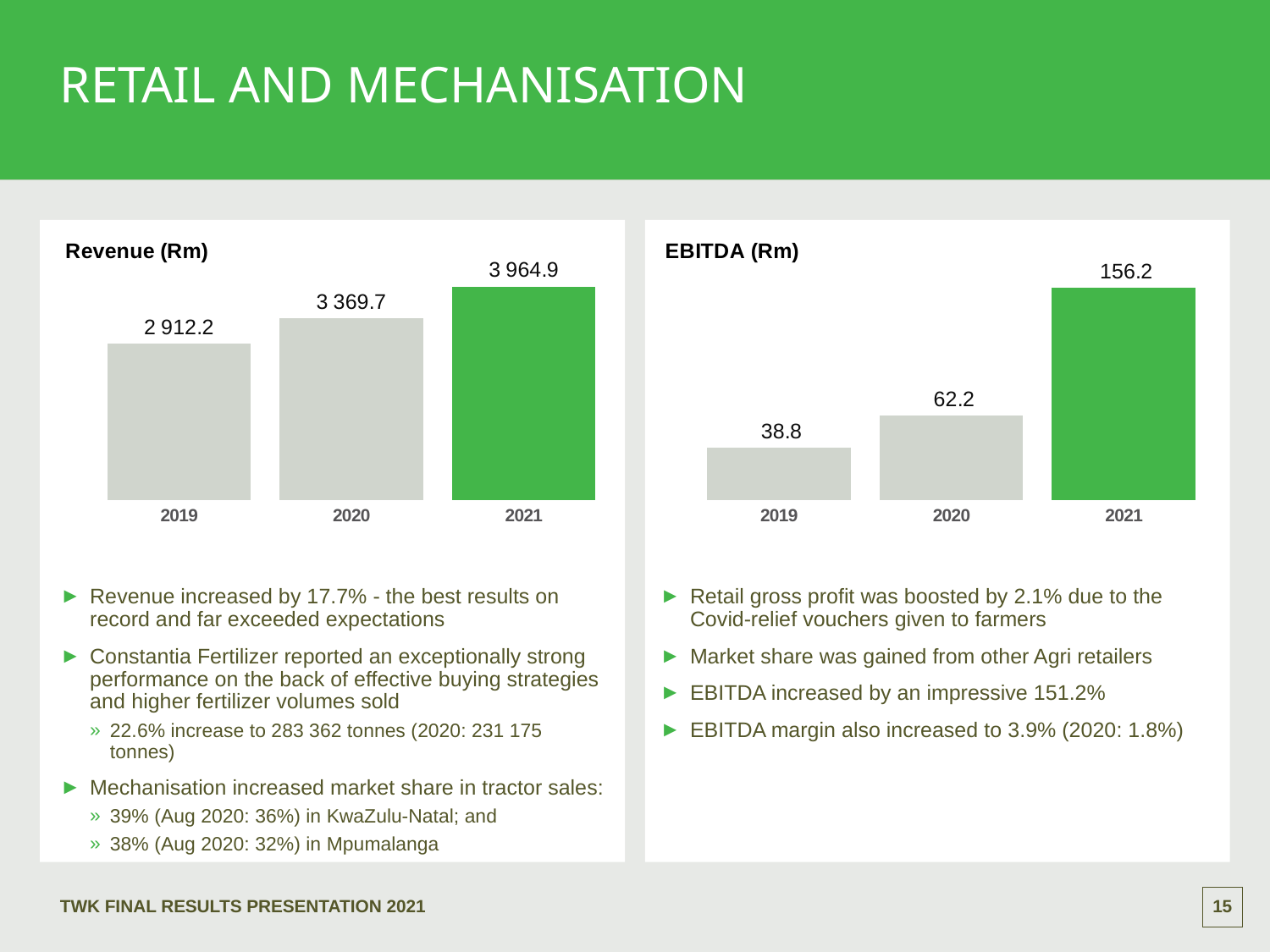
In the Revenue (Rm) chart, what is the difference between the 2021 and 2020 values? 595.2 How many years are shown in the Revenue (Rm) chart? 3 In the EBITDA (Rm) chart, what is the value for 2020? 62.2 What kind of chart is the EBITDA (Rm) chart? Bar chart In the Revenue (Rm) chart, what is the value for 2021? 3 964.9 In the Revenue (Rm) chart, what is the value for 2019? 2 912.2 In the EBITDA (Rm) chart, what is the value for 2019? 38.8 In the EBITDA (Rm) chart, which year has the highest value? 2021 In the EBITDA (Rm) chart, what is the difference between the 2021 and 2020 values? 94.0 In the Revenue (Rm) chart, which year has the lowest value? 2019 In the EBITDA (Rm) chart, which is larger, the value for 2019 or the value for 2020? 2020 In the Revenue (Rm) chart, do the values rise or fall from 2019 to 2021? Rise